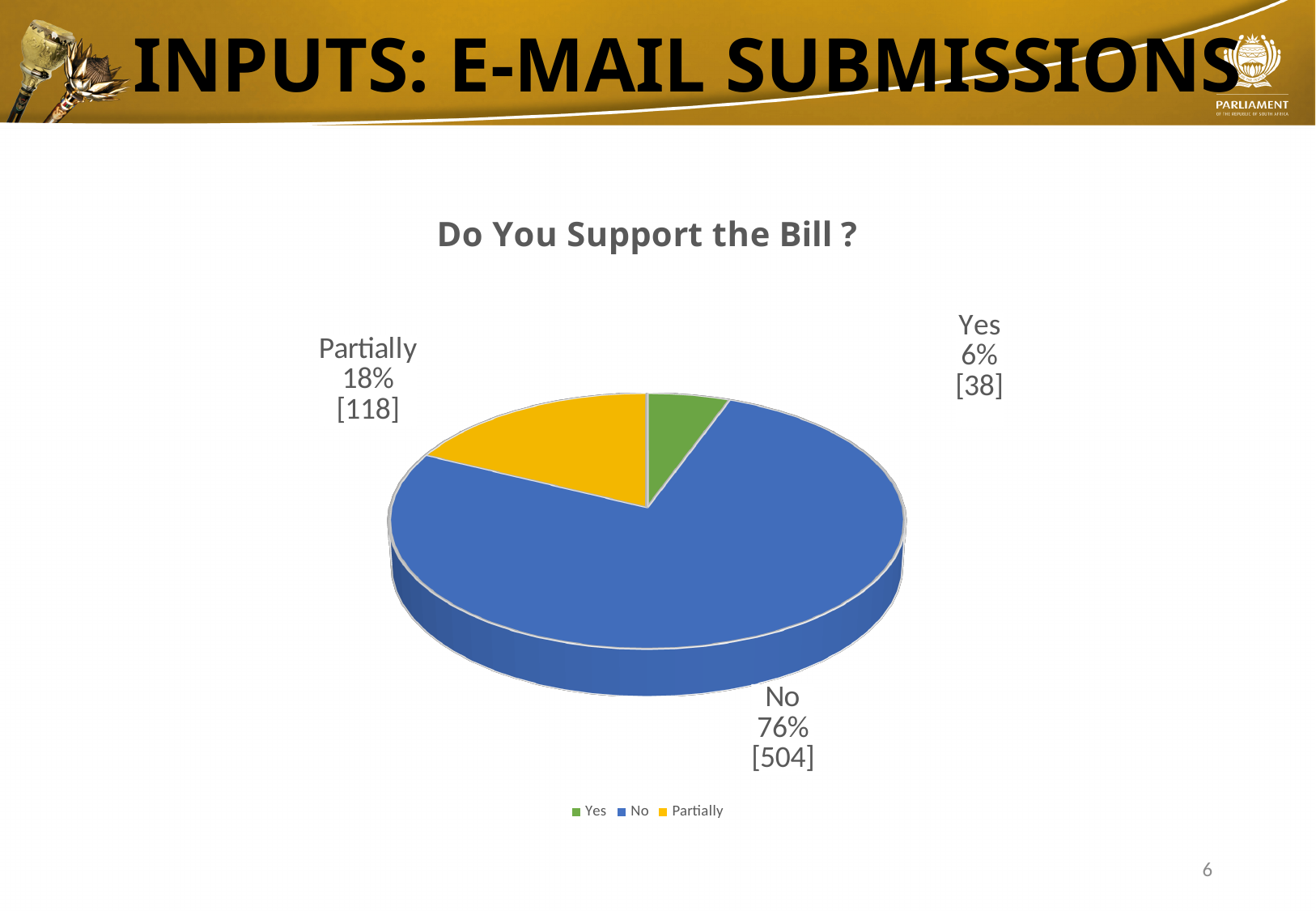
How many e-mail submissions answered "Yes"? 38 What percentage of submissions answered "Yes"? 6% Which has more submissions, "Partially" or "Yes"? Partially How many e-mail submissions answered "Partially"? 118 What kind of chart is shown on the slide? Pie chart What is the difference in the number of submissions between "No" and "Partially"? 386 What is the title of the chart? Do You Support the Bill ? Which response has the largest share of the pie? No What colour is the "Partially" slice? Yellow Which response has the smallest share of the pie? Yes What percentage of e-mail submissions answered "No" to supporting the Bill? 76% How many response categories does the pie chart show? 3